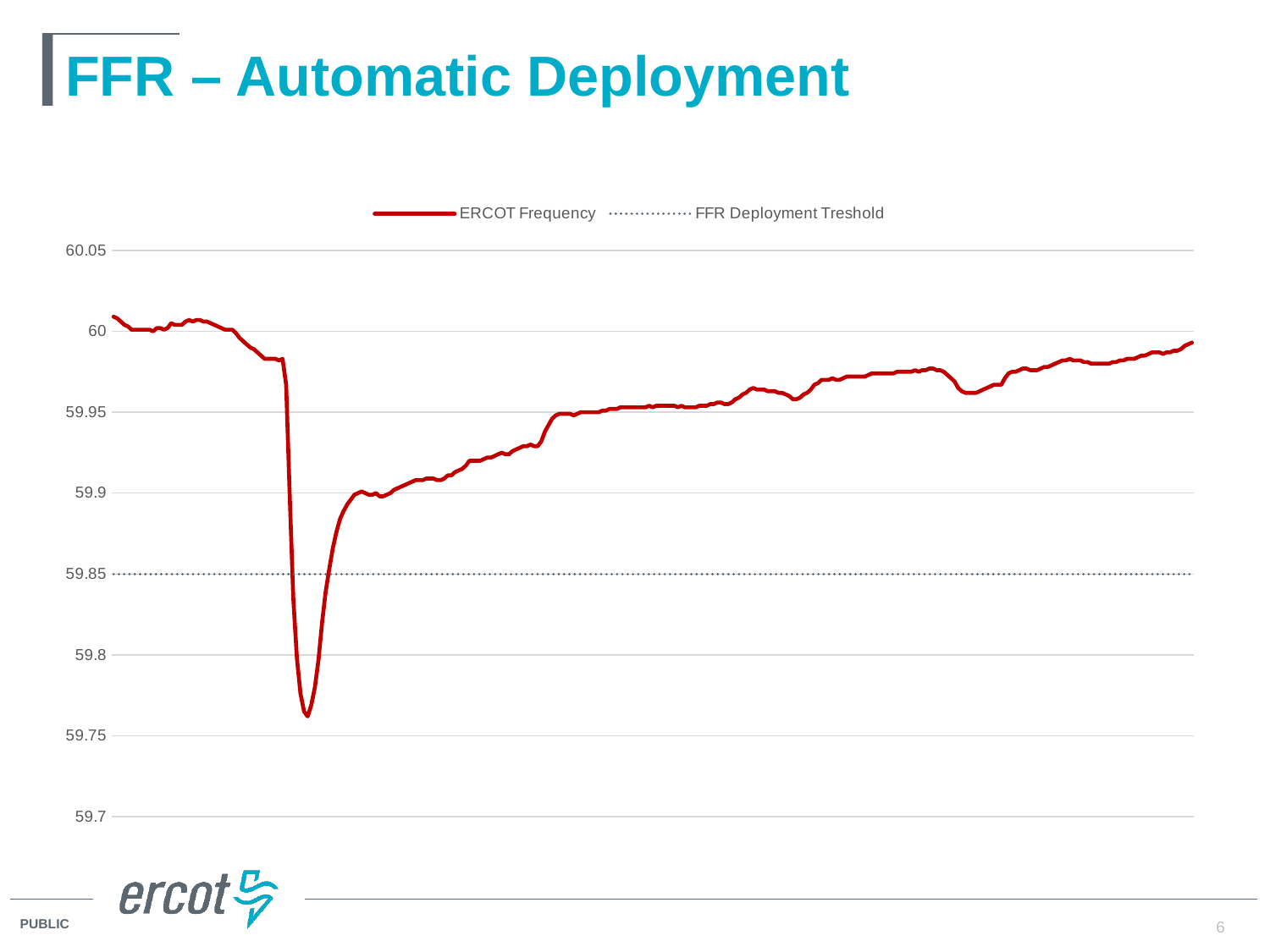
Is the ERCOT Frequency value at the far left start of the chart greater or less than 60? greater How many series does the legend list? 2 Is the lowest point of the ERCOT Frequency line greater or less than 59.75? greater Is the ERCOT Frequency value at the far right end of the chart greater or less than 59.95? greater What is the title of the slide containing the chart? FFR – Automatic Deployment At what value does the dotted FFR Deployment Treshold line sit on the vertical axis? 59.85 What are the two series named in the legend? ERCOT Frequency and FFR Deployment Treshold Does the ERCOT Frequency line dip below the FFR Deployment Treshold line at any point? yes After the sharp dip, does the ERCOT Frequency line generally rise or fall toward the right side of the chart? rise What kind of chart is shown on the slide? line chart What is the highest value labelled on the vertical axis? 60.05